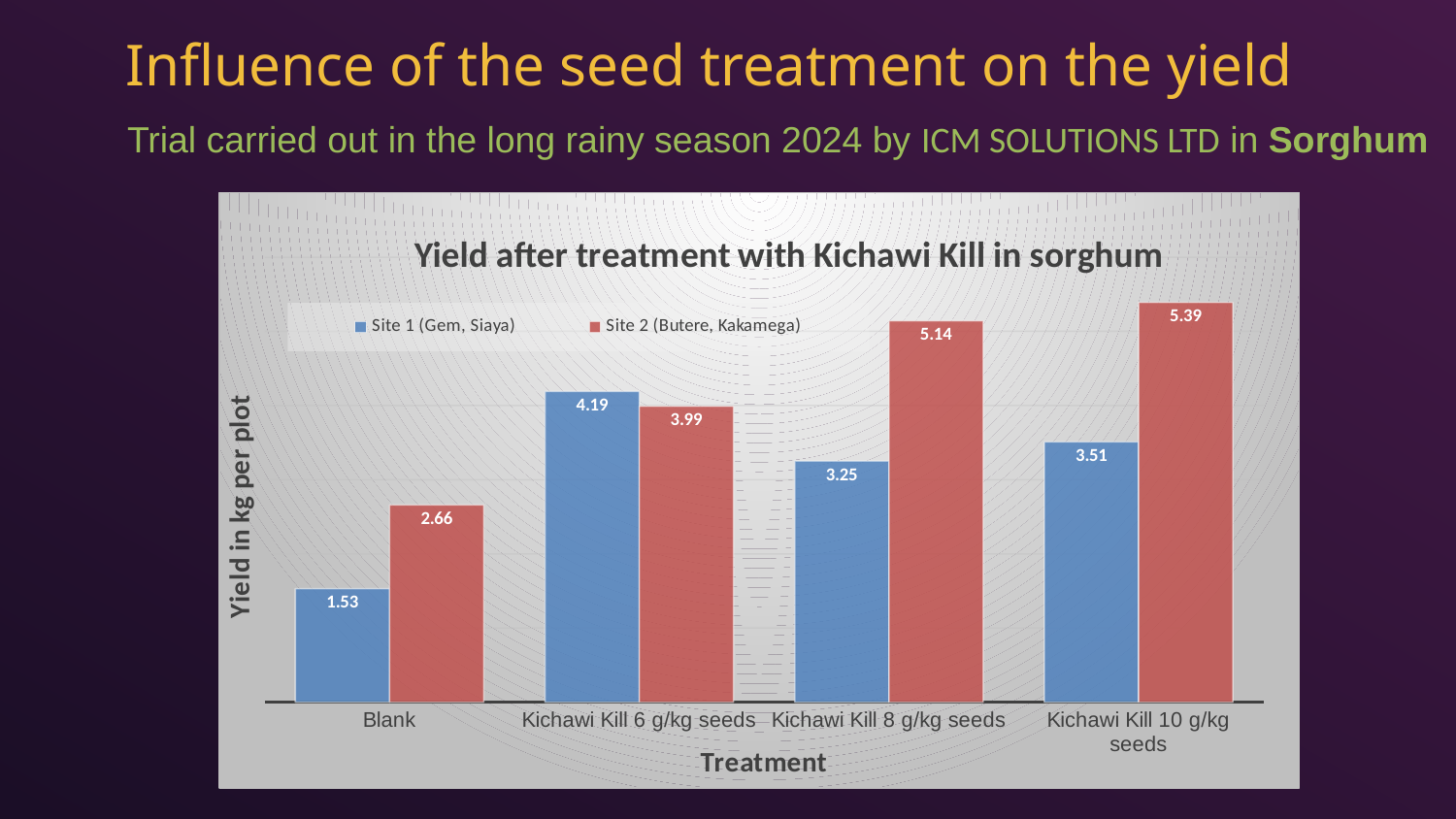
What is the yield for Site 1 (Gem, Siaya) with Kichawi Kill 8 g/kg seeds? 3.25 What kind of chart is shown on the slide? Bar chart What is the yield for Site 1 (Gem, Siaya) under the Blank treatment? 1.53 Which treatment gives the highest yield for Site 2 (Butere, Kakamega)? Kichawi Kill 10 g/kg seeds For Kichawi Kill 6 g/kg seeds, which site has the higher yield? Site 1 (Gem, Siaya) How many series does the legend list? 2 Which treatment gives the lowest yield for Site 1 (Gem, Siaya)? Blank What is the label of the y axis? Yield in kg per plot What is the yield for Site 2 (Butere, Kakamega) with Kichawi Kill 10 g/kg seeds? 5.39 What is the title of the chart? Yield after treatment with Kichawi Kill in sorghum What is the difference between the Site 2 and Site 1 yields for Kichawi Kill 8 g/kg seeds? 1.89 How many treatments are shown on the x axis? 4